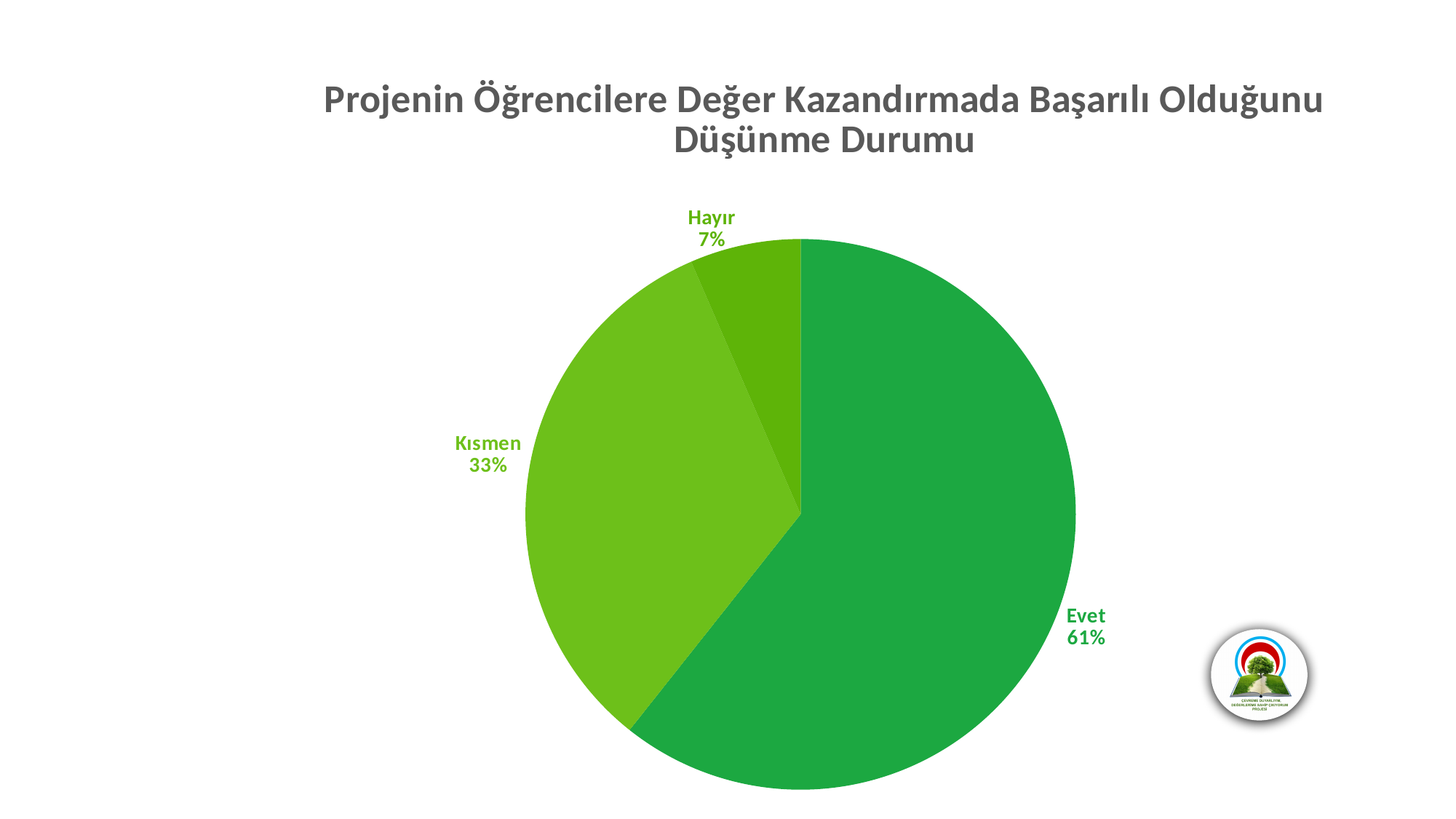
What is the difference in percentage points between Kısmen and Hayır? 26 Which category has the largest share of the pie? Evet How many slices does the pie chart have? 3 What share of the pie does the Evet slice represent? 61% What percentage is shown for Evet? 61% What is the difference in percentage points between Evet and Kısmen? 28 What is the title of the chart? Projenin Öğrencilere Değer Kazandırmada Başarılı Olduğunu Düşünme Durumu What kind of chart is shown on the slide? pie chart What percentage is shown for Hayır? 7% Which is larger, the share for Kısmen or the share for Hayır? Kısmen What percentage is shown for Kısmen? 33% Which category has the smallest share of the pie? Hayır